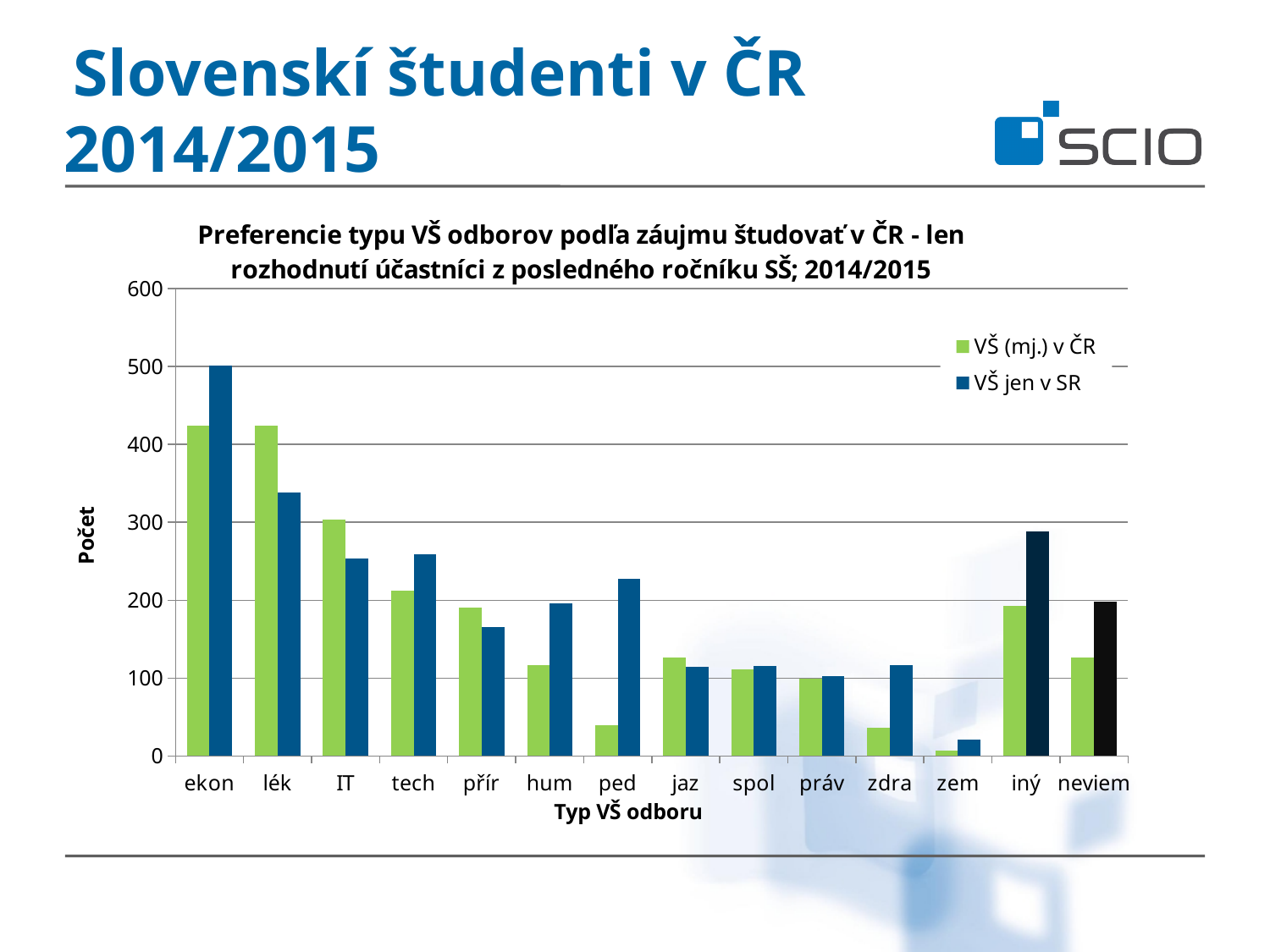
Which category has the highest value for the series VŠ jen v SR? ekon What type of chart is shown on the slide? bar chart How many series does the legend list? 2 Is the value for ped in the series VŠ (mj.) v ČR greater or less than 100? less How many categories are shown on the x axis? 14 What is the label of the y axis? Počet Which category has the lowest value for the series VŠ (mj.) v ČR? zem For the category ped, which series has the larger value: VŠ (mj.) v ČR or VŠ jen v SR? VŠ jen v SR Is the value for tech in the series VŠ jen v SR greater or less than 200? greater Is the value for ekon in the series VŠ jen v SR greater or less than 400? greater Which category has the lowest value for the series VŠ jen v SR? zem For the category lék, which series has the larger value: VŠ (mj.) v ČR or VŠ jen v SR? VŠ (mj.) v ČR